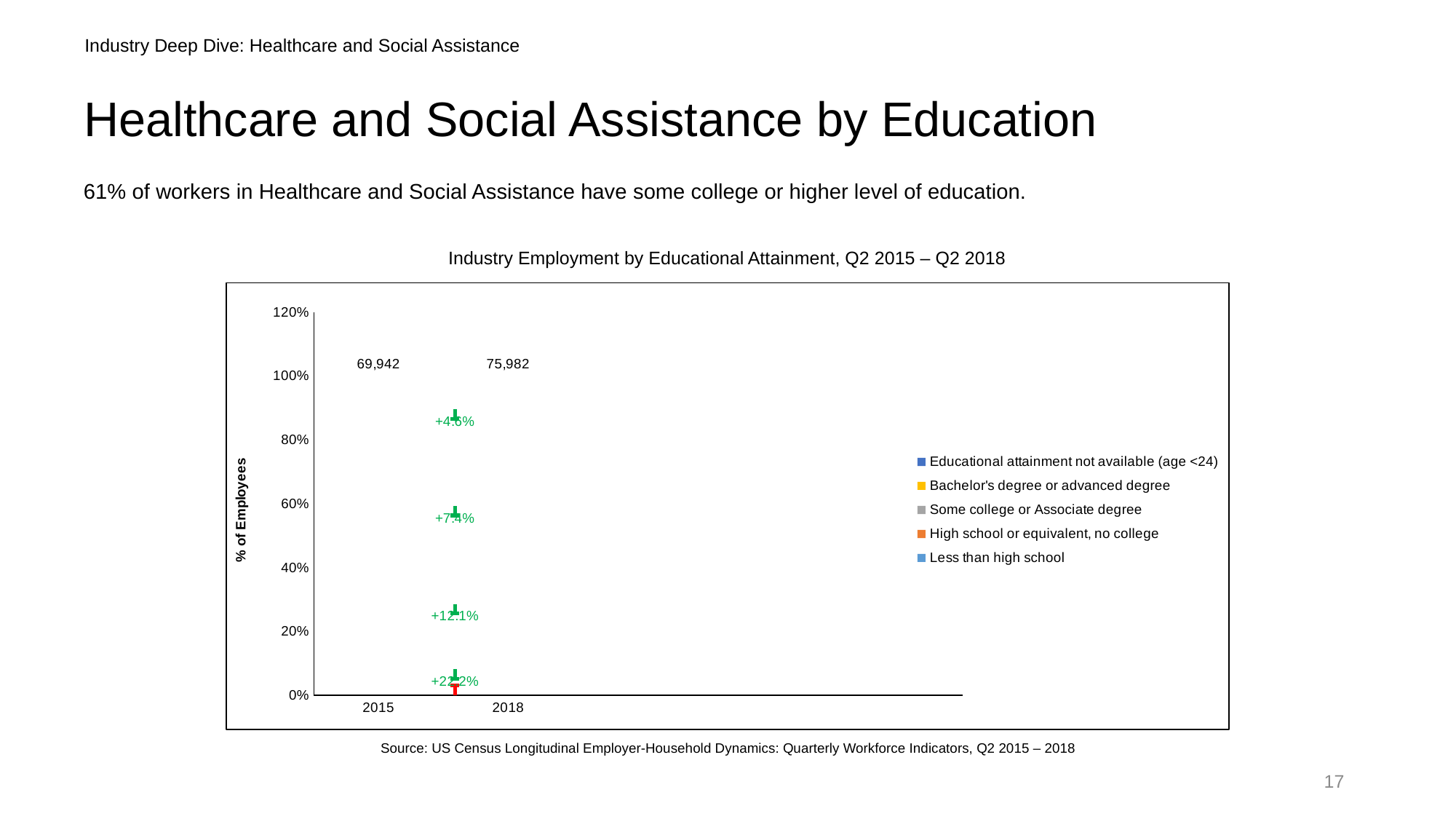
How many series does the legend list? 5 Which year has the smaller total employment figure printed above it? 2015 What is the difference between the total employment figures printed for 2018 and 2015? 6,040 How many categories are shown on the x axis? 2 Which year has the larger total employment figure printed above it, 2015 or 2018? 2018 What total employment figure is printed above the 2018 column? 75,982 What total employment figure is printed above the 2015 column? 69,942 What is the title of the chart? Industry Employment by Educational Attainment, Q2 2015 – Q2 2018 What is the label on the y axis? % of Employees What is the highest value shown on the y axis? 120%